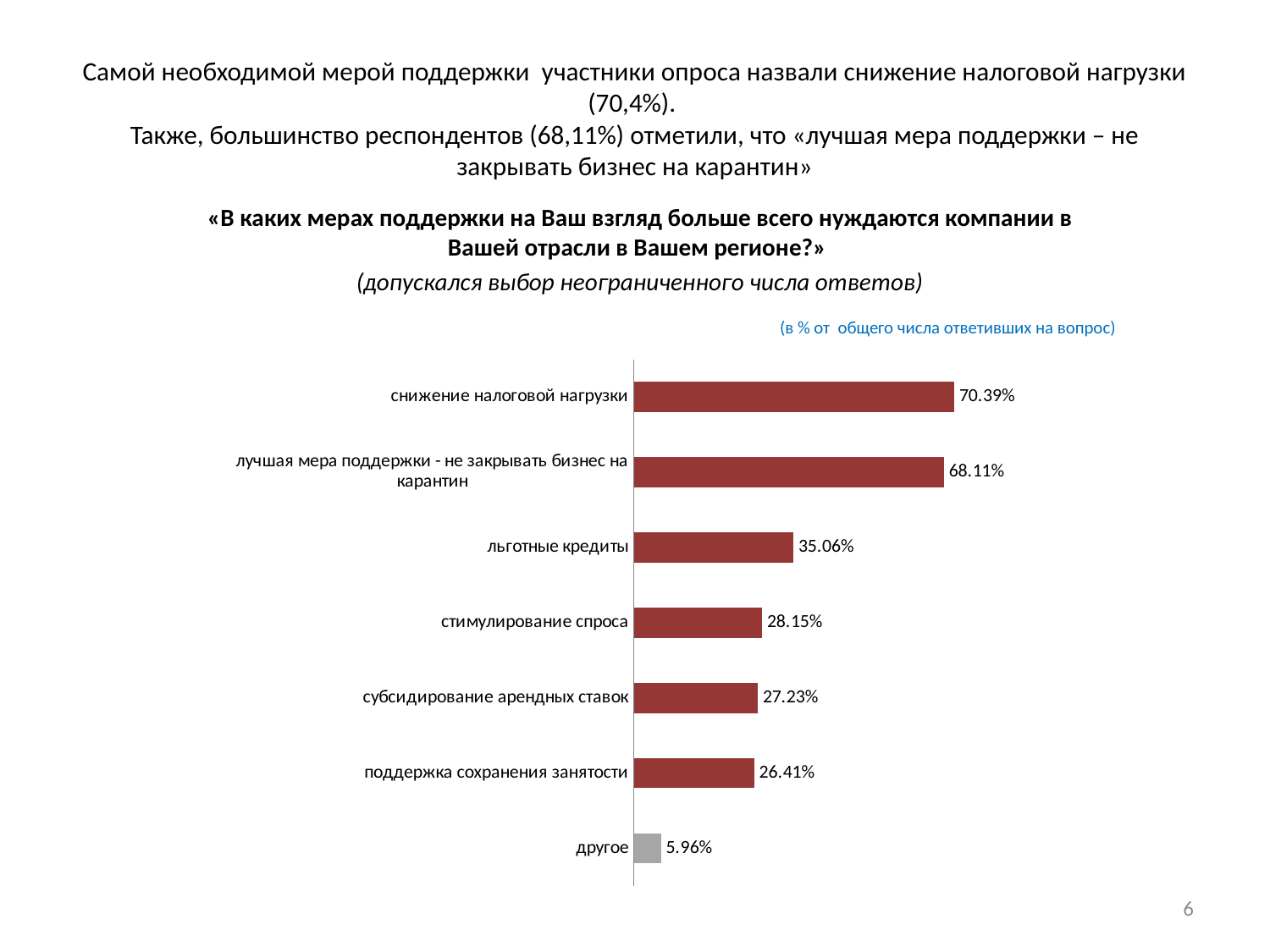
Which is larger: «стимулирование спроса» or «поддержка сохранения занятости»? стимулирование спроса What is the value for «снижение налоговой нагрузки»? 70.39% Which bar is shown in a different colour (grey) from the others? другое Which category has the lowest value? другое What is the value for «другое»? 5.96% What is the value for «льготные кредиты»? 35.06% What is the difference between «снижение налоговой нагрузки» and «лучшая мера поддержки - не закрывать бизнес на карантин»? 2.28% How many categories are shown in the chart? 7 What is the value for «субсидирование арендных ставок»? 27.23% What is the difference between «льготные кредиты» and «стимулирование спроса»? 6.91% What kind of chart is shown on the slide? bar chart Which category has the highest value? снижение налоговой нагрузки